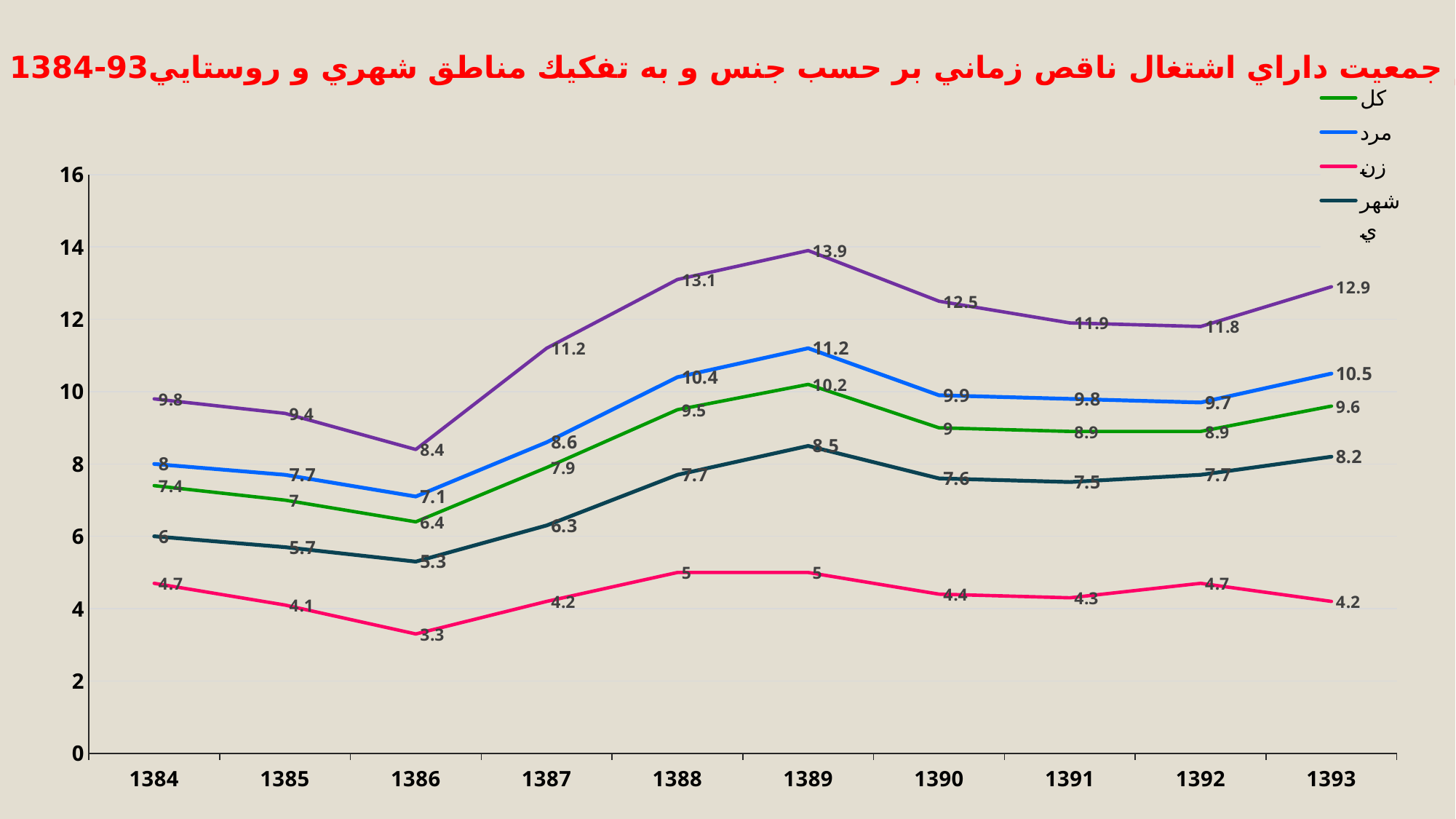
What is the value for کل in 1393? 9.6 What is the difference between the مرد value and the زن value in 1389? 6.2 How many years are shown on the x axis of the chart? 10 What kind of chart is shown on the slide? line chart Which year has the larger value for کل, 1384 or 1393? 1393 What is the value for مرد in 1389? 11.2 What colour is the line for مرد? blue What is the value for شهري in 1388? 7.7 In which year does the کل series reach its lowest value? 1386 What is the value for زن in 1386? 3.3 Does the زن series rise or fall from 1384 to 1386? fall In which year does the مرد series reach its highest value? 1389